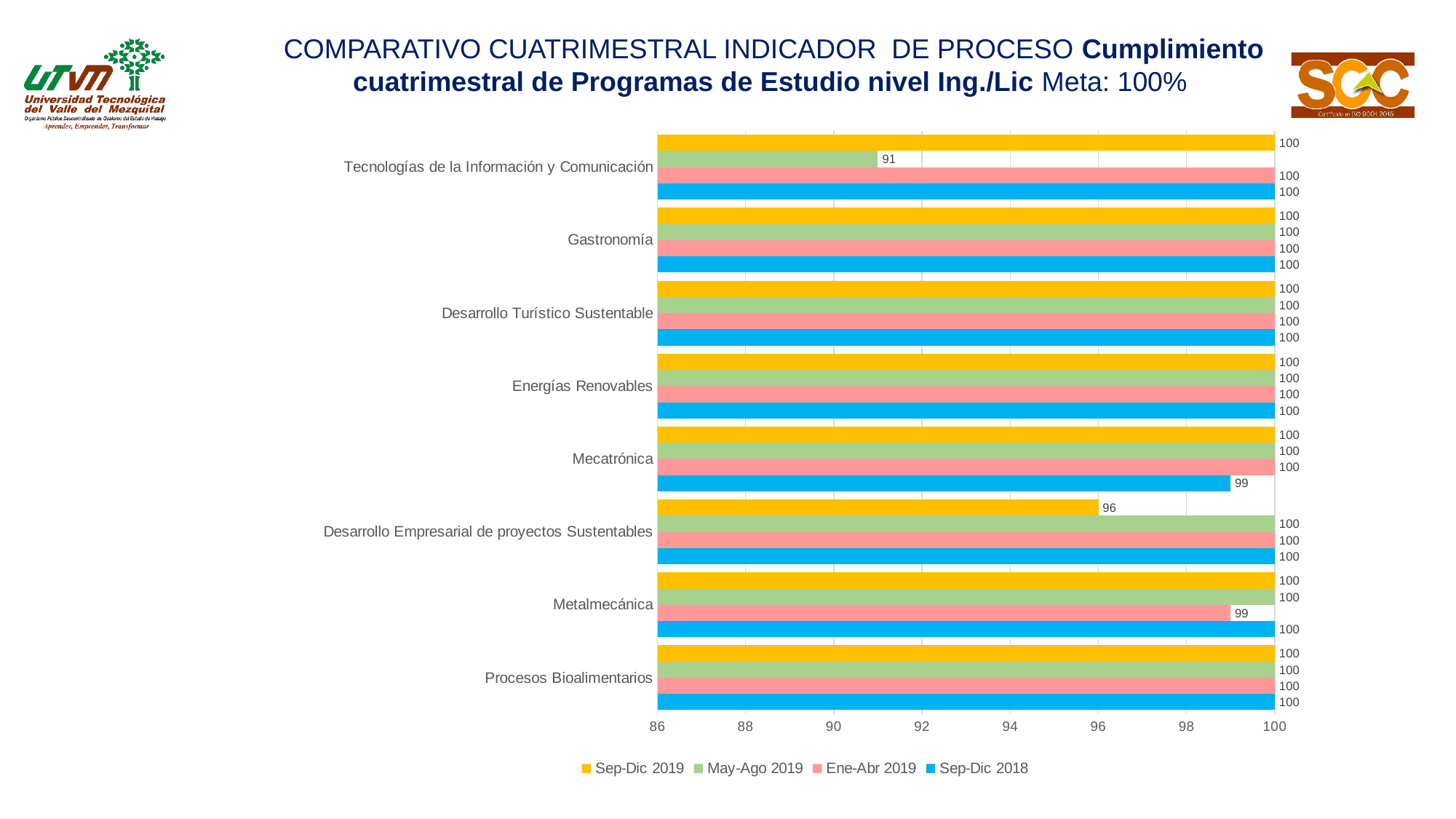
What is the May-Ago 2019 value for Tecnologías de la Información y Comunicación? 91 What type of chart is shown on the slide? bar chart Which program has the lowest May-Ago 2019 value? Tecnologías de la Información y Comunicación How many series does the legend list? 4 What is the Ene-Abr 2019 value for Metalmecánica? 99 How many programs (categories) are shown on the chart? 8 Which series is shown in yellow in the legend? Sep-Dic 2019 What is the difference between the Sep-Dic 2019 value and the May-Ago 2019 value for Desarrollo Empresarial de proyectos Sustentables? 4 What is the Sep-Dic 2019 value for Gastronomía? 100 What is the Sep-Dic 2019 value for Desarrollo Empresarial de proyectos Sustentables? 96 Which is larger for Tecnologías de la Información y Comunicación: the Sep-Dic 2019 value or the May-Ago 2019 value? Sep-Dic 2019 What is the Sep-Dic 2018 value for Mecatrónica? 99